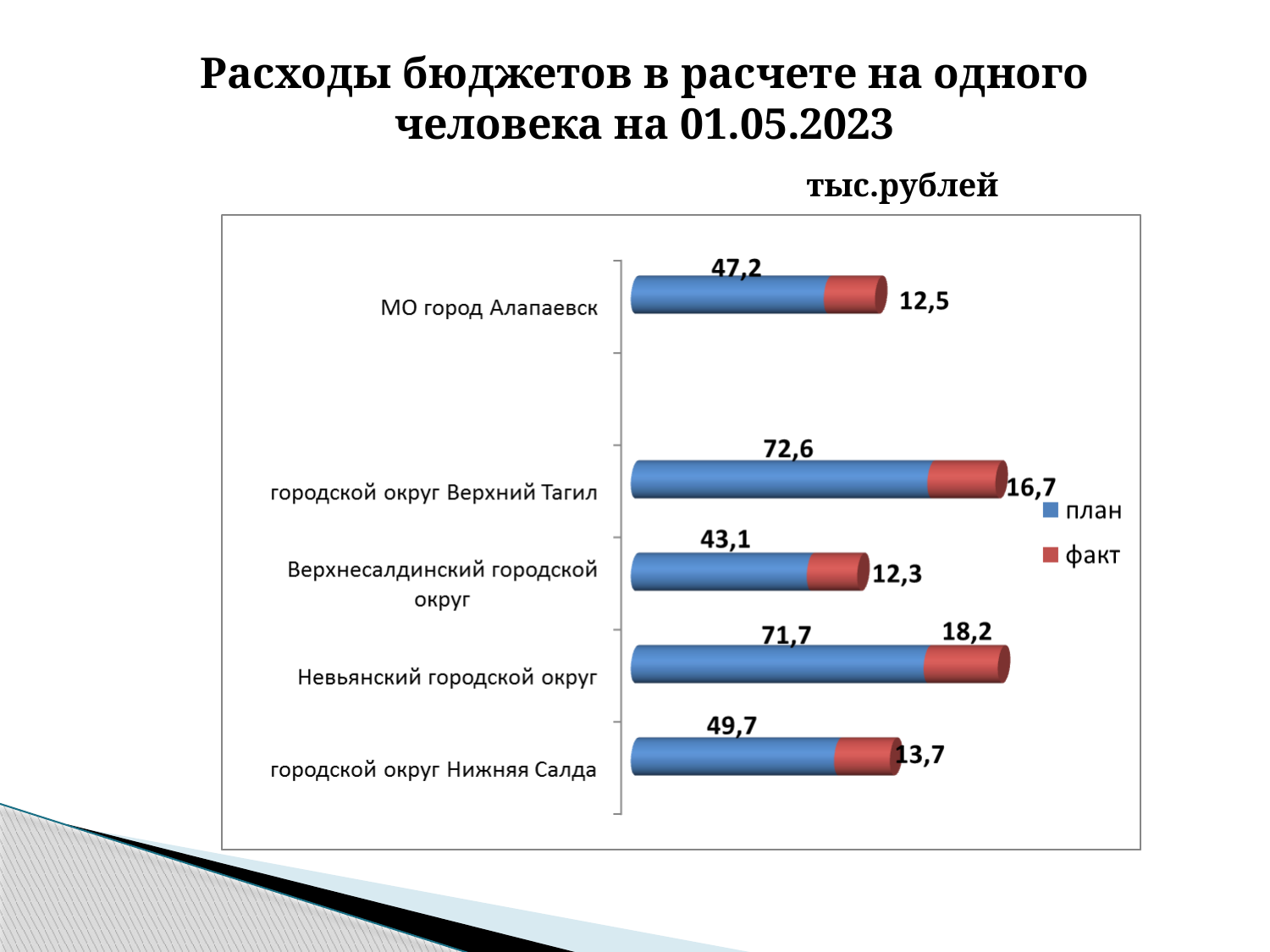
What kind of chart is shown on the slide? bar chart What is the план value for МО город Алапаевск? 47,2 What is the факт value for городской округ Нижняя Салда? 13,7 What is the план value for Верхнесалдинский городской округ? 43,1 What is the difference between the план and факт values for городской округ Верхний Тагил? 55,9 What is the факт value for Невьянский городской округ? 18,2 Which category has the highest план value? городской округ Верхний Тагил What is the total of the stacked bar for Невьянский городской округ? 89,9 Which is larger: the факт value for МО город Алапаевск or the факт value for городской округ Верхний Тагил? городской округ Верхний Тагил Which category has the lowest план value? Верхнесалдинский городской округ How many series does the legend list? 2 Which category has the highest факт value? Невьянский городской округ